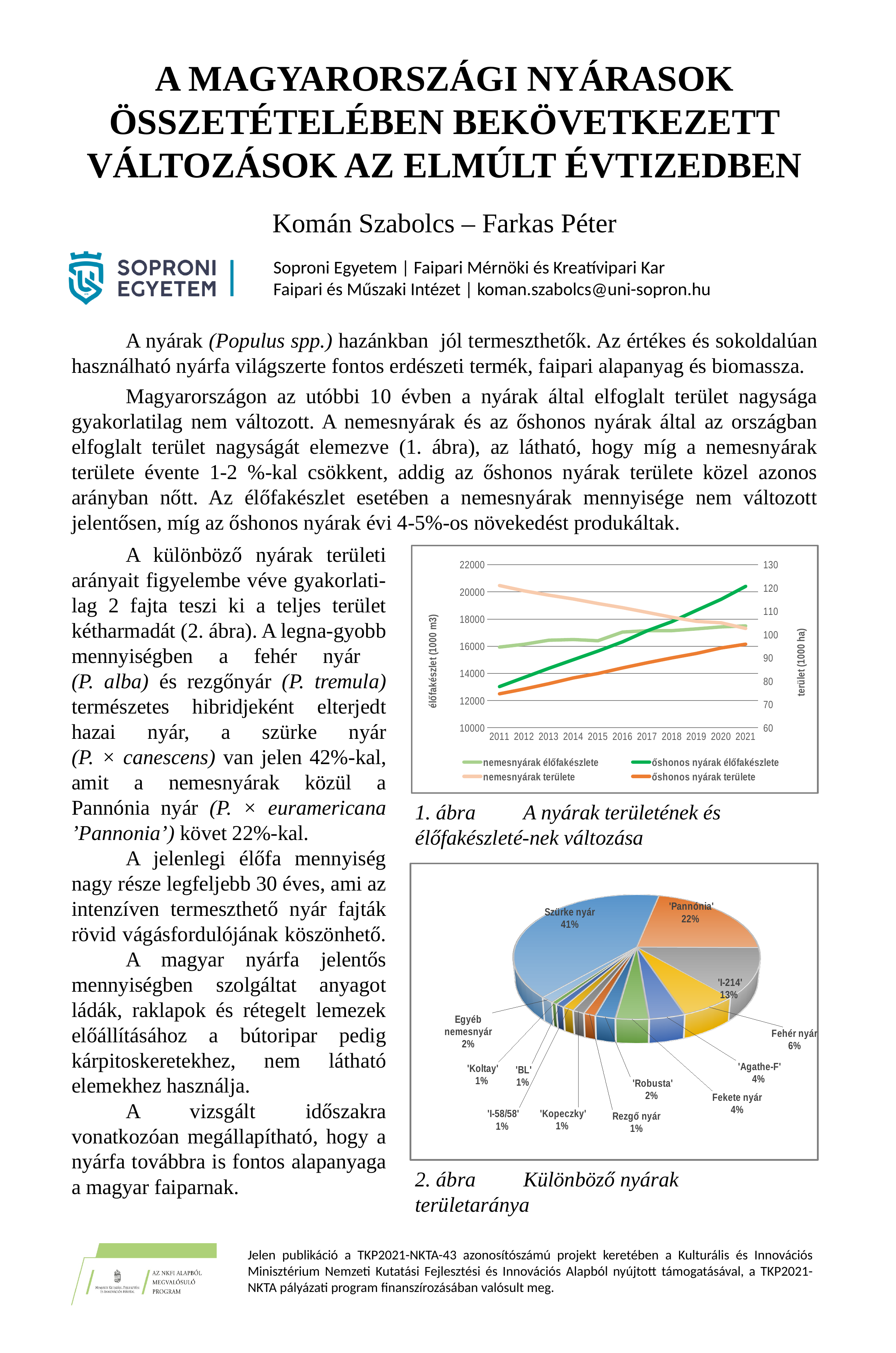
What kind of chart is the chart titled '1. ábra A nyárak területének és élőfakészletének változása'? line chart What kind of chart is the chart titled '2. ábra Különböző nyárak területaránya'? pie chart In the line chart (1. ábra), how many series does the legend list? 4 In the line chart (1. ábra), does the 'nemesnyárak területe' series rise or fall from 2011 to 2021? fall In the line chart (1. ábra), how many years are shown on the x axis? 11 In the pie chart (2. ábra), what is the difference between the shares of Szürke nyár and 'I-214'? 28% In the pie chart (2. ábra), what share does 'Pannónia' have? 22% In the pie chart (2. ábra), how many slices are there? 13 In the line chart (1. ábra), is the value for 'őshonos nyárak élőfakészlete' in 2011 greater or less than 14000? less In the line chart (1. ábra), is the value for 'őshonos nyárak élőfakészlete' in 2021 greater or less than 18000? greater In the pie chart (2. ábra), which category has the largest share? Szürke nyár In the line chart (1. ábra), does the 'őshonos nyárak élőfakészlete' series rise or fall from 2011 to 2021? rise